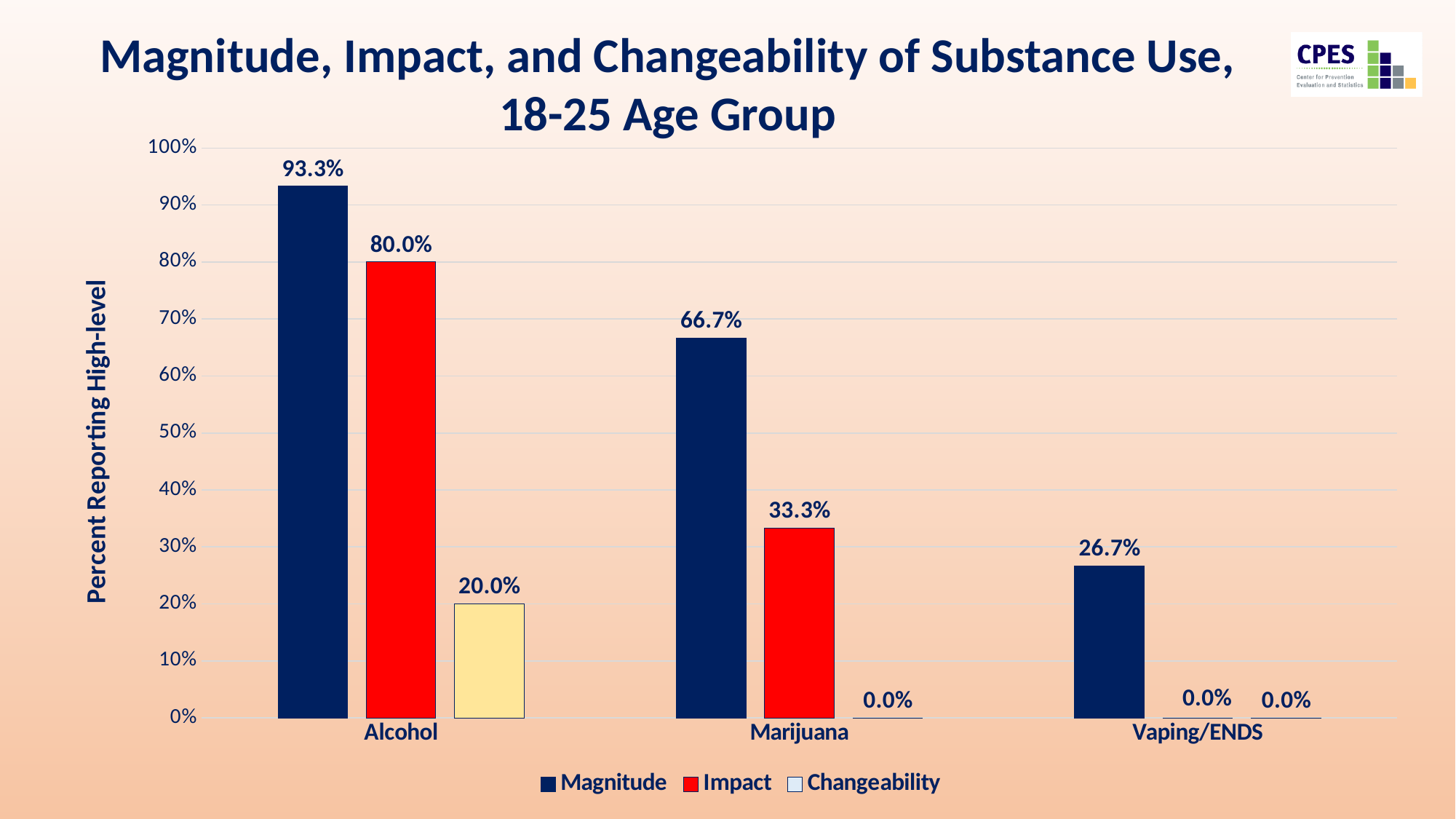
What is the Magnitude value for Alcohol? 93.3% What is the Magnitude value for Vaping/ENDS? 26.7% What kind of chart is shown on the slide? Bar chart What is the Impact value for Marijuana? 33.3% How many substance categories are shown on the x axis? 3 What is the label of the y axis? Percent Reporting High-level What is the difference between the Impact values for Alcohol and Marijuana? 46.7% How many series does the legend list? 3 Which is larger: the Magnitude value for Marijuana or the Impact value for Alcohol? Impact value for Alcohol Which substance has the highest Magnitude value? Alcohol Which substance has the lowest Magnitude value? Vaping/ENDS What is the Changeability value for Alcohol? 20.0%